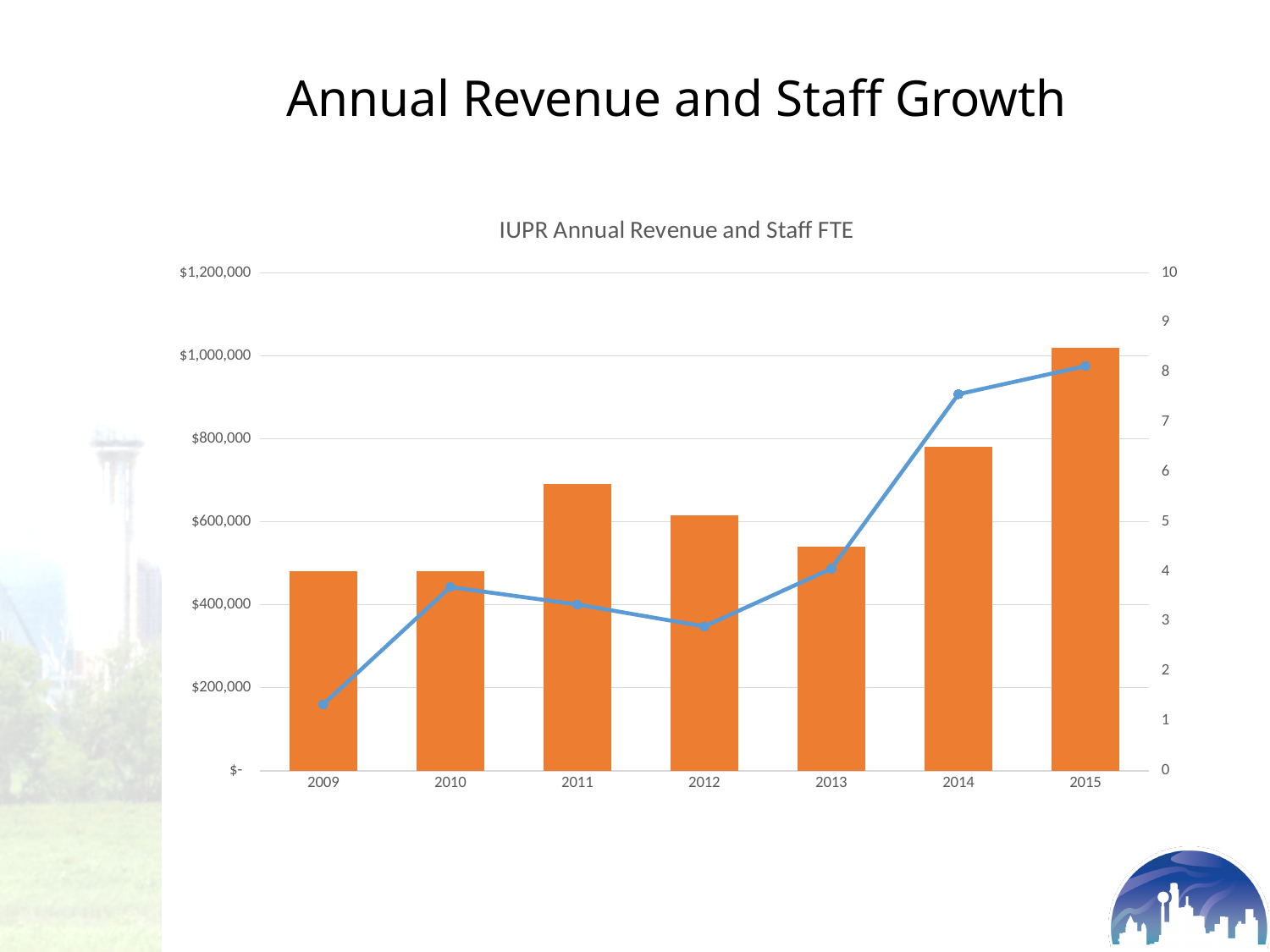
What kind of chart is this? A bar chart combined with a line chart How many years are shown on the x axis of the chart? 7 Is the revenue bar for 2015 greater or less than $1,000,000? greater Which year has a taller revenue bar, 2011 or 2012? 2011 Does the staff FTE line rise or fall from 2012 to 2015? rise Is the revenue bar for 2011 greater or less than $600,000? greater Which year has the lowest point on the staff FTE line? 2009 Is the staff FTE value for 2014 greater or less than 7? greater What is the title of the chart? IUPR Annual Revenue and Staff FTE Which year has the tallest revenue bar? 2015